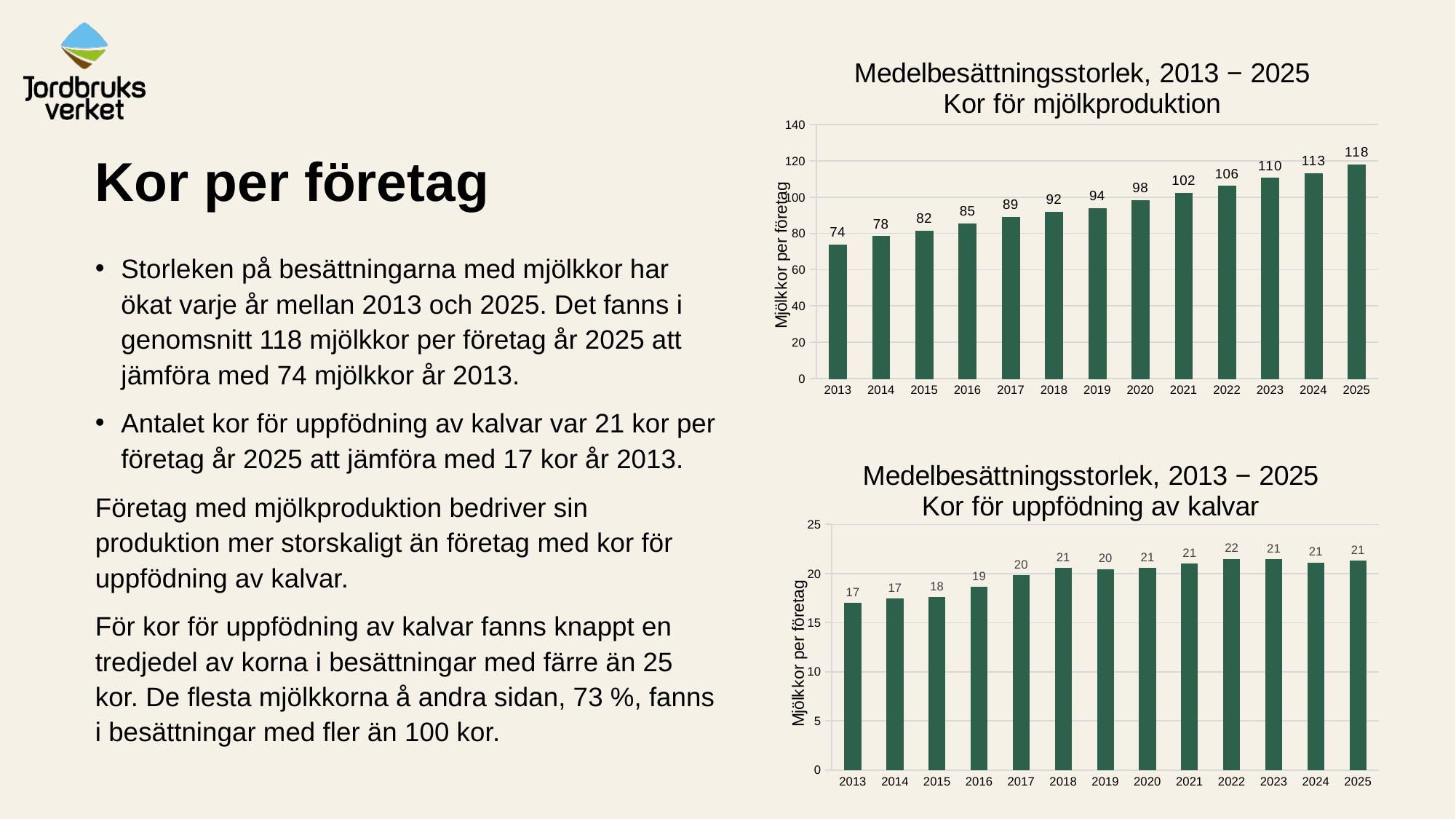
What is the y-axis label of the top chart (Kor för mjölkproduktion)? Mjölkkor per företag In the bottom chart (Kor för uppfödning av kalvar), which is larger, the value for 2013 or the value for 2025? 2025 In the top chart (Kor för mjölkproduktion), what is the value for 2013? 74 What kind of chart is the bottom chart (Kor för uppfödning av kalvar)? bar chart In the top chart (Kor för mjölkproduktion), what is the difference between the values for 2025 and 2013? 44 In the top chart (Kor för mjölkproduktion), which year has the highest value? 2025 In the bottom chart (Kor för uppfödning av kalvar), what is the value for 2022? 22 In the bottom chart (Kor för uppfödning av kalvar), what is the value for 2016? 19 In the top chart (Kor för mjölkproduktion), do the values rise or fall from 2013 to 2025? rise In the top chart (Kor för mjölkproduktion), what is the value for 2025? 118 In the top chart (Kor för mjölkproduktion), which year has the lowest value? 2013 In the top chart (Kor för mjölkproduktion), how many years are plotted? 13